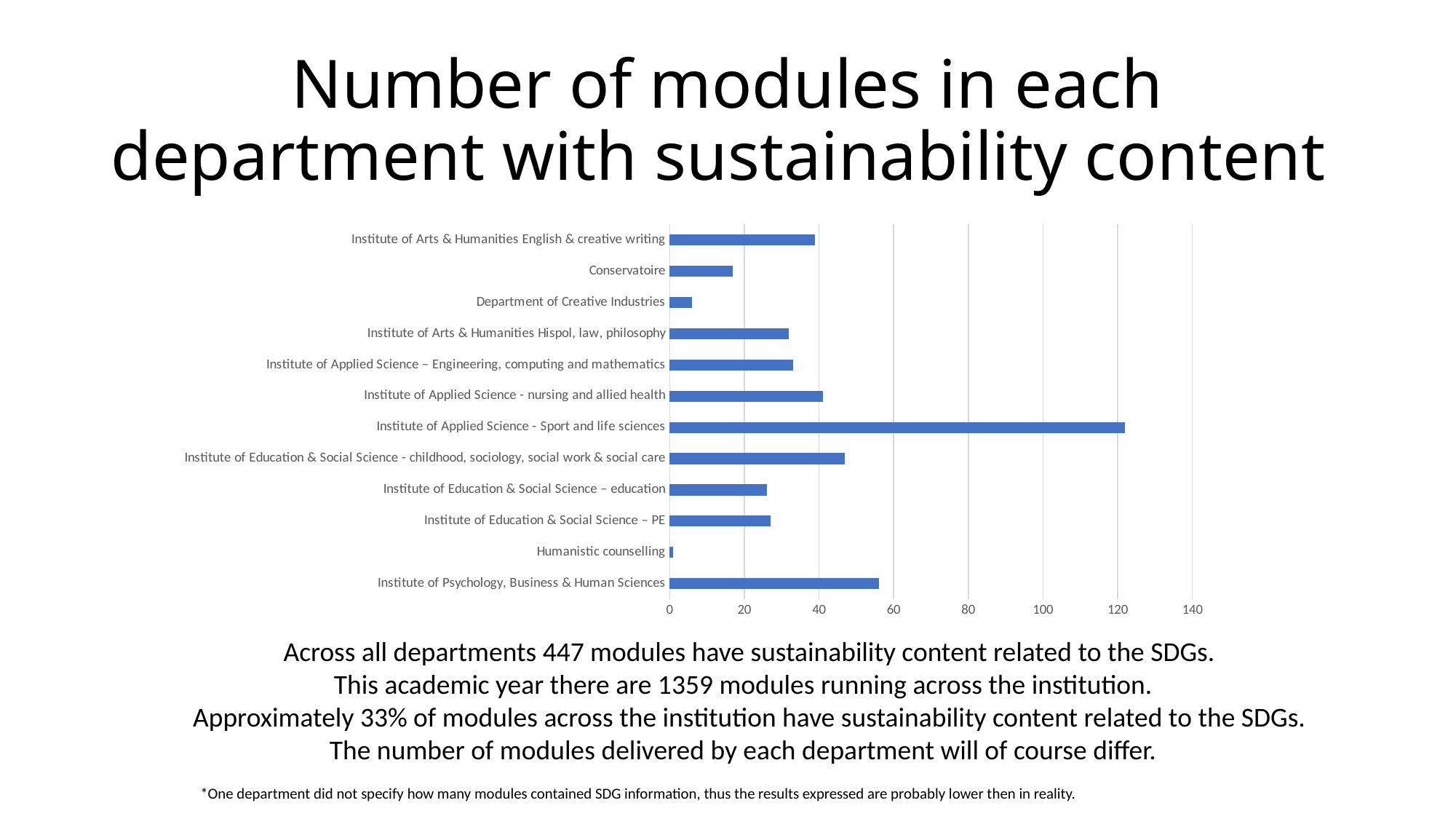
What is the title of the chart on the slide? Number of modules in each department with sustainability content Is the value for Institute of Psychology, Business & Human Sciences greater or less than 40? greater Which department has the highest number of modules with sustainability content? Institute of Applied Science - Sport and life sciences Is the value for Institute of Applied Science - Sport and life sciences greater or less than 100? greater Which department has the lowest number of modules with sustainability content? Humanistic counselling What kind of chart is shown on the slide? bar chart Which has more modules with sustainability content: Institute of Psychology, Business & Human Sciences or Conservatoire? Institute of Psychology, Business & Human Sciences Is the value for Institute of Education & Social Science - childhood, sociology, social work & social care greater or less than 40? greater How many departments are shown in the chart? 12 Which has more modules with sustainability content: Department of Creative Industries or Institute of Applied Science - nursing and allied health? Institute of Applied Science - nursing and allied health